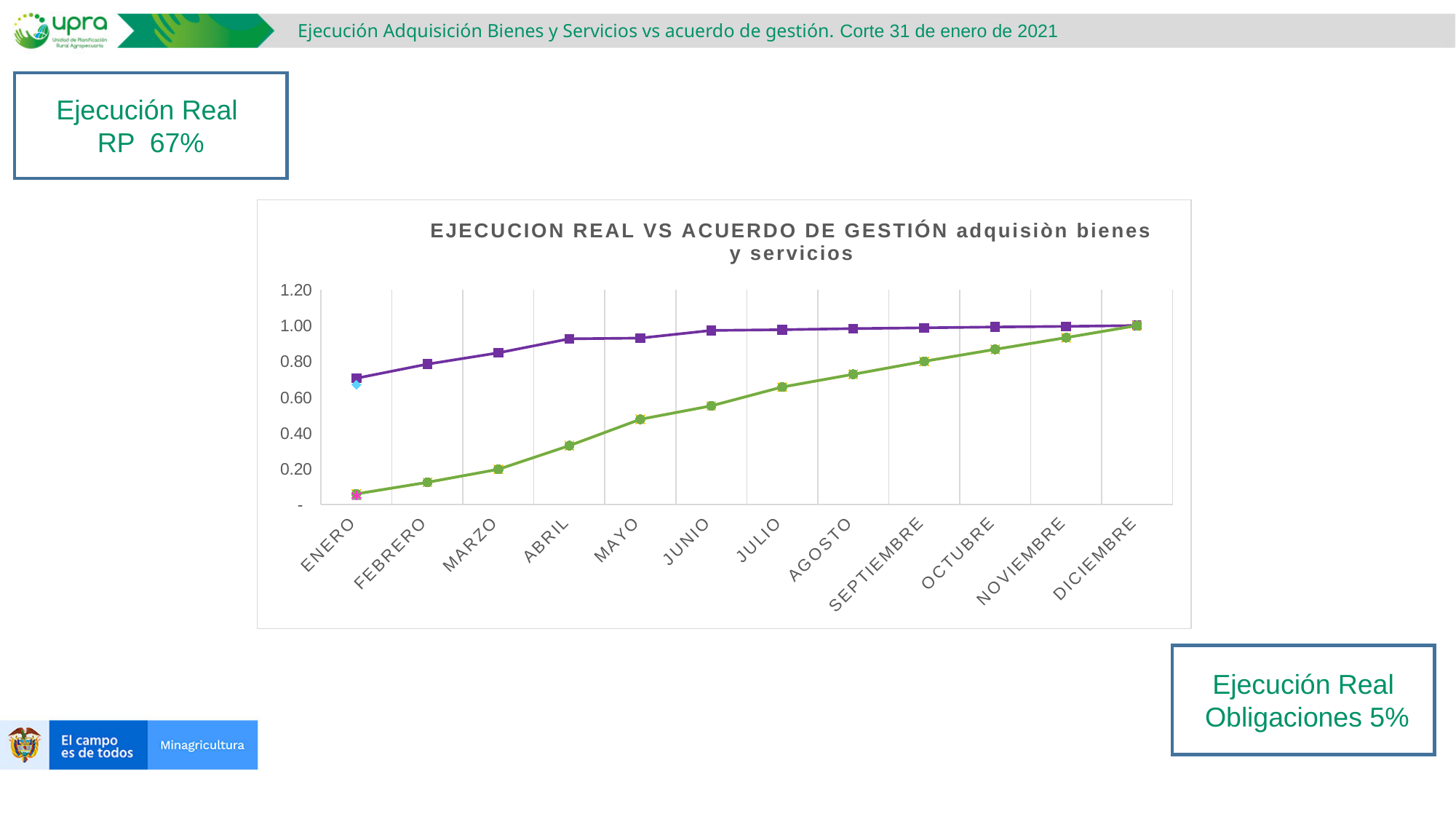
Does the purple line rise or fall from ENERO to DICIEMBRE? rise In JUNIO, which line has the higher value, the purple line or the green line? purple line Does the green line rise or fall from ENERO to DICIEMBRE? rise What kind of chart is shown on the slide? line chart Is the value of the green line for JULIO greater or less than 0.80? less In which month does the green line have its lowest value? ENERO How many months are shown along the x axis of the chart? 12 Is the value of the green line for MARZO greater or less than 0.40? less Is the value of the purple line for ABRIL greater or less than 0.80? greater What is the title of the chart? EJECUCION REAL VS ACUERDO DE GESTIÓN adquisiòn bienes y servicios